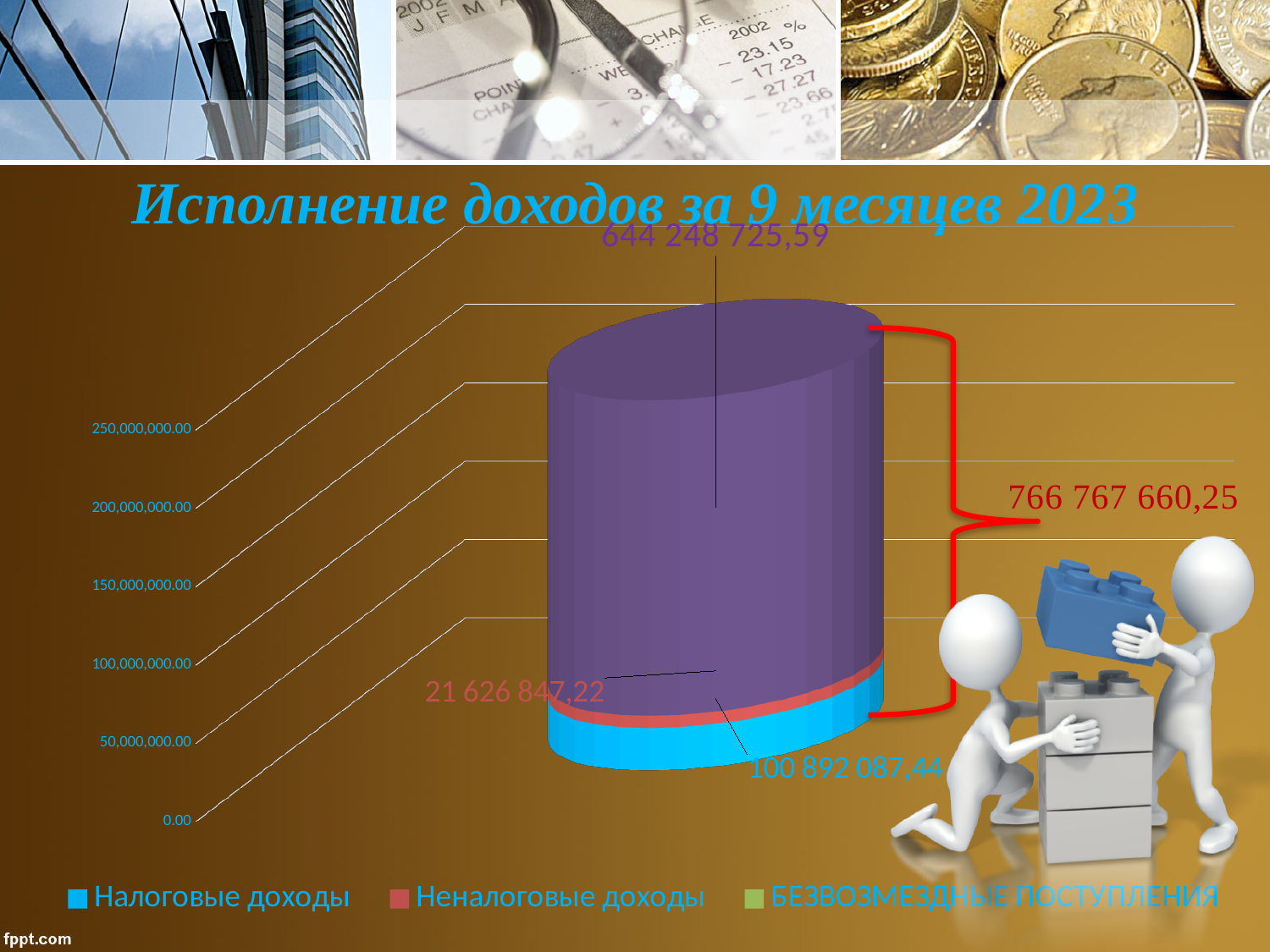
What is the value shown for Налоговые доходы? 100 892 087,44 What is the difference between БЕЗВОЗМЕЗДНЫЕ ПОСТУПЛЕНИЯ and Налоговые доходы? 543 356 638,15 How many series does the legend list? 3 Which is larger, Налоговые доходы or Неналоговые доходы? Налоговые доходы What is the difference between Налоговые доходы and Неналоговые доходы? 79 265 240,22 What is the total of the stacked bar, as printed on the slide? 766 767 660,25 What is the value shown for БЕЗВОЗМЕЗДНЫЕ ПОСТУПЛЕНИЯ? 644 248 725,59 Which series has the largest value in the stacked bar? БЕЗВОЗМЕЗДНЫЕ ПОСТУПЛЕНИЯ What is the value shown for Неналоговые доходы? 21 626 847,22 What is the title of the slide? Исполнение доходов за 9 месяцев 2023 Which series has the smallest value in the stacked bar? Неналоговые доходы What kind of chart is shown on the slide? Bar chart